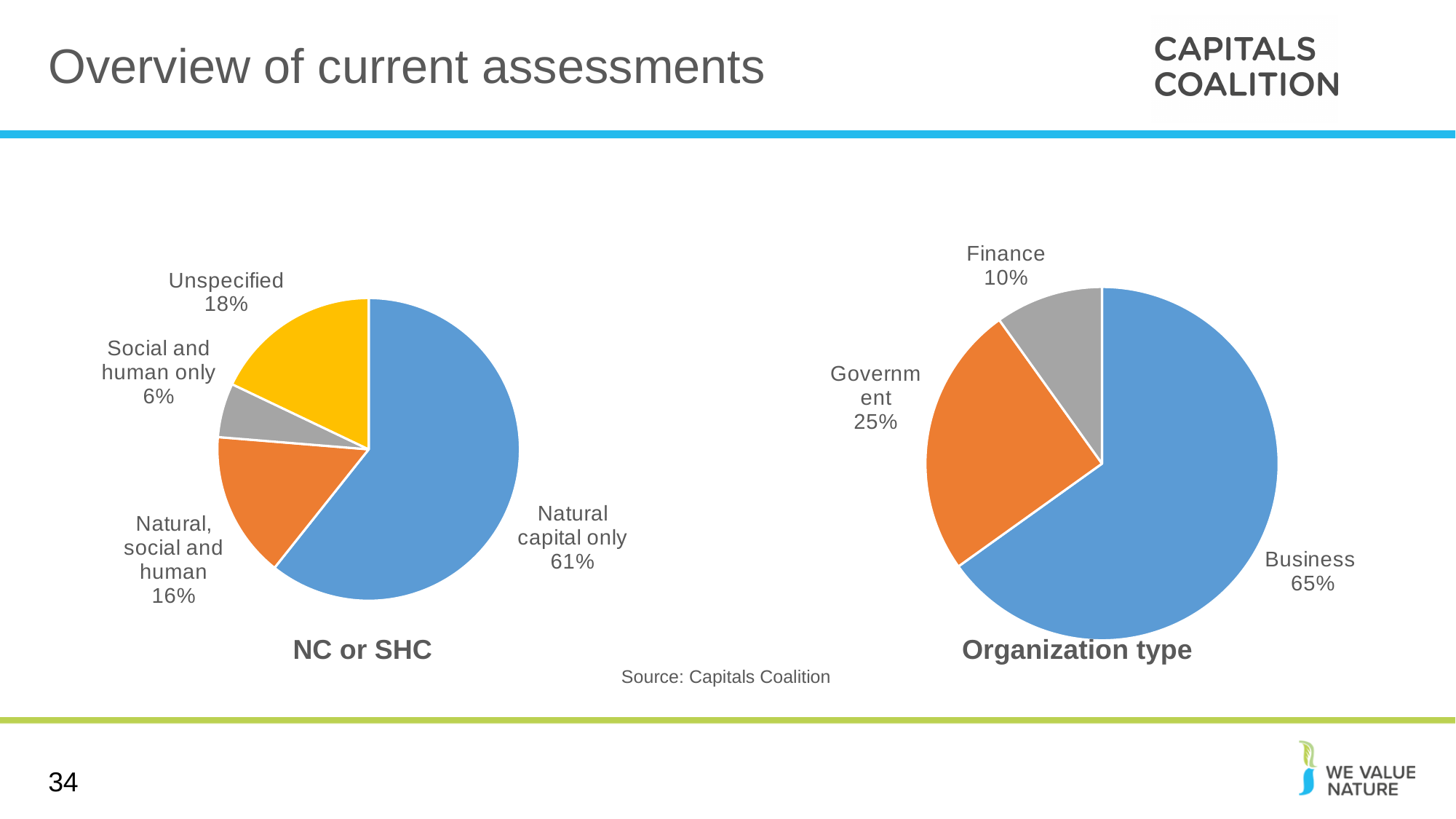
In the 'Organization type' chart, what share is labelled for 'Government'? 25% In the 'Organization type' chart, how many categories are shown? 3 In the 'Organization type' chart, what is the difference between the 'Business' share and the 'Finance' share? 55% In the 'NC or SHC' chart, which is larger: 'Natural, social and human' or 'Social and human only'? Natural, social and human What type of chart is the 'Organization type' chart? Pie chart In the 'NC or SHC' chart, what is the difference between the 'Unspecified' share and the 'Natural, social and human' share? 2% In the 'NC or SHC' chart, what share is labelled for 'Unspecified'? 18% In the 'Organization type' chart, which category has the largest slice? Business What source is cited below the charts? Capitals Coalition In the 'NC or SHC' chart, how many slices does the pie have? 4 In the 'NC or SHC' chart, which category has the smallest slice? Social and human only In the 'NC or SHC' chart, what share is labelled for 'Natural capital only'? 61%